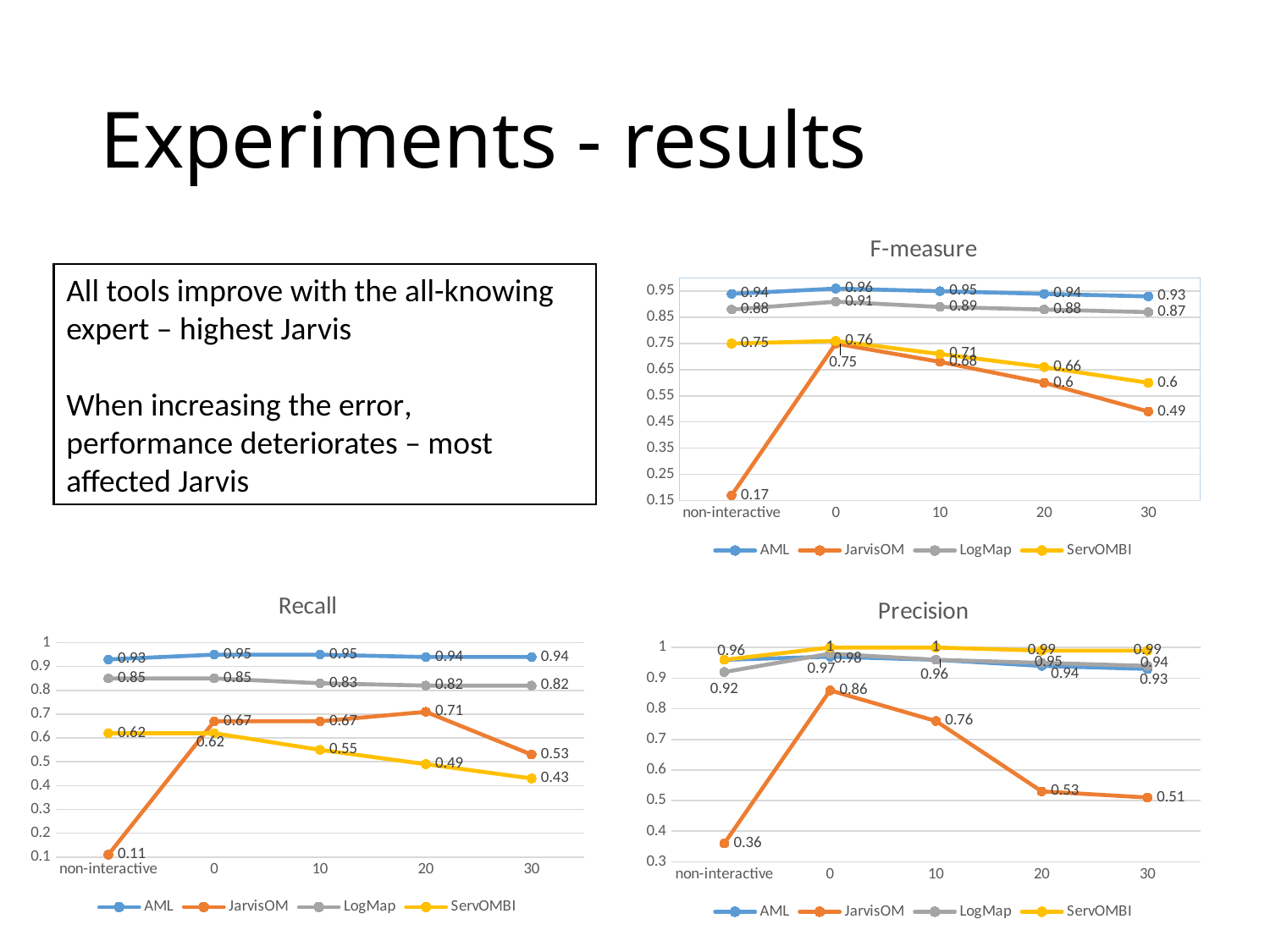
In the Recall chart, what is the value for ServOMBI at error level 30? 0.43 In the F-measure chart, what is the difference between the JarvisOM values at error level 0 and error level 30? 0.26 In the Precision chart, is the JarvisOM value at error level 20 greater or less than 0.6? less In the F-measure chart, which series has the lowest value at error level 30? JarvisOM How many series does the legend of the Precision chart list? 4 In the Recall chart, which series has the highest value at error level 10? AML In the F-measure chart, what is the value for JarvisOM at the non-interactive setting? 0.17 In the Precision chart, what is the value for JarvisOM at error level 0? 0.86 In the Recall chart, what is the value for JarvisOM at error level 20? 0.71 In the Recall chart, does the ServOMBI line rise or fall from error level 0 to error level 30? fall In the F-measure chart, what is the value for ServOMBI at error level 30? 0.6 In the F-measure chart, what is the value for AML at error level 0? 0.96